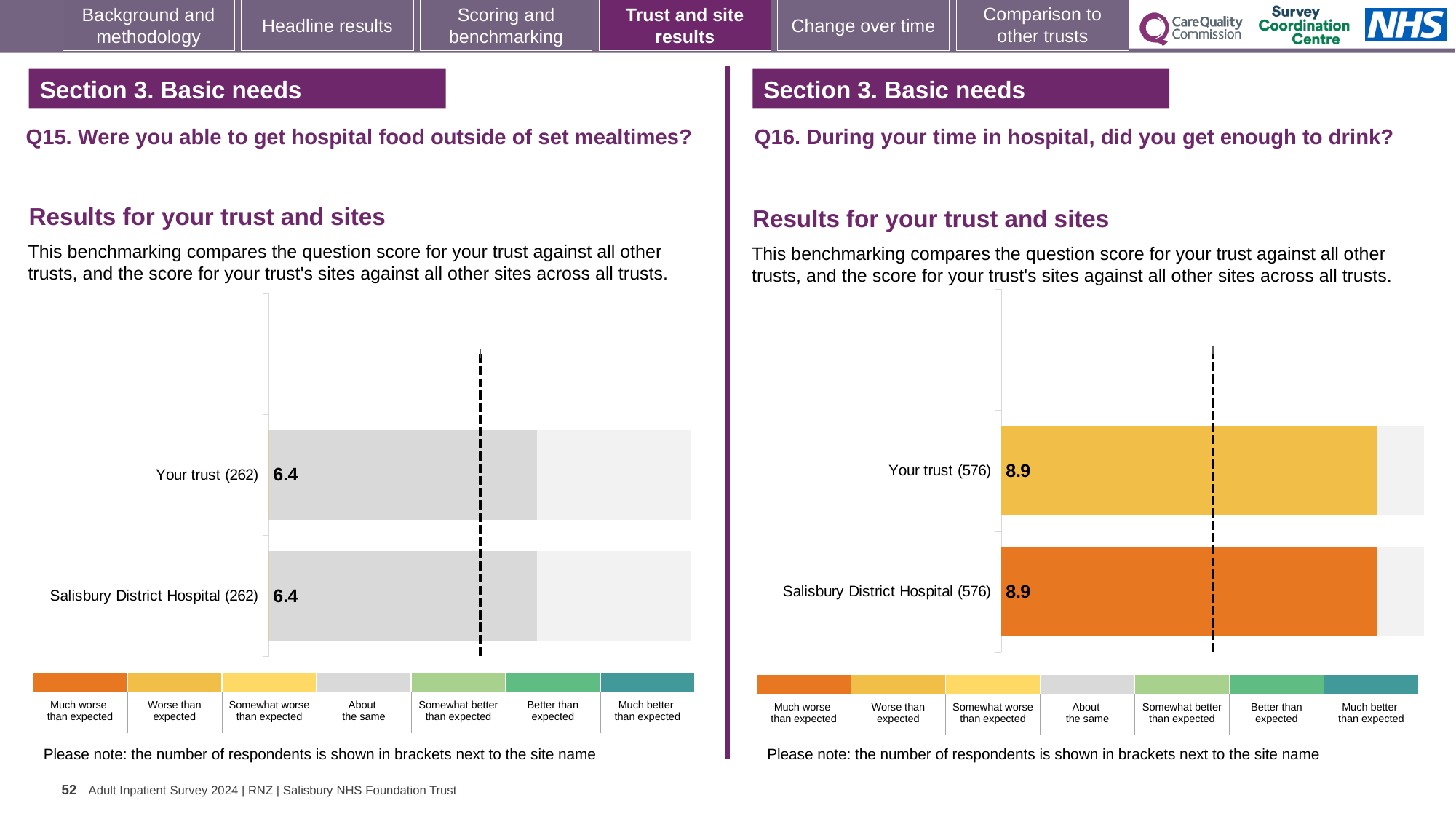
In the Q15 chart on the left, what is the difference between the score for Your trust and the score for Salisbury District Hospital? 0.0 In the Q15 chart on the left, what is the score for Your trust? 6.4 What kind of chart is the Q16 chart on the right? Bar chart How many bars are plotted in the Q15 chart on the left? 2 How many bars are plotted in the Q16 chart on the right? 2 In the Q16 chart on the right, which benchmark category does the colour of the Salisbury District Hospital bar correspond to in the key? Much worse than expected In the Q15 chart on the left, how many respondents are shown in brackets for Your trust? 262 In the Q16 chart on the right, how many respondents are shown in brackets for Salisbury District Hospital? 576 In the Q16 chart on the right, what is the difference between the score for Your trust and the score for Salisbury District Hospital? 0.0 In the Q15 chart on the left, what is the score for Salisbury District Hospital? 6.4 In the Q16 chart on the right, what is the score for Salisbury District Hospital? 8.9 In the Q16 chart on the right, what is the score for Your trust? 8.9